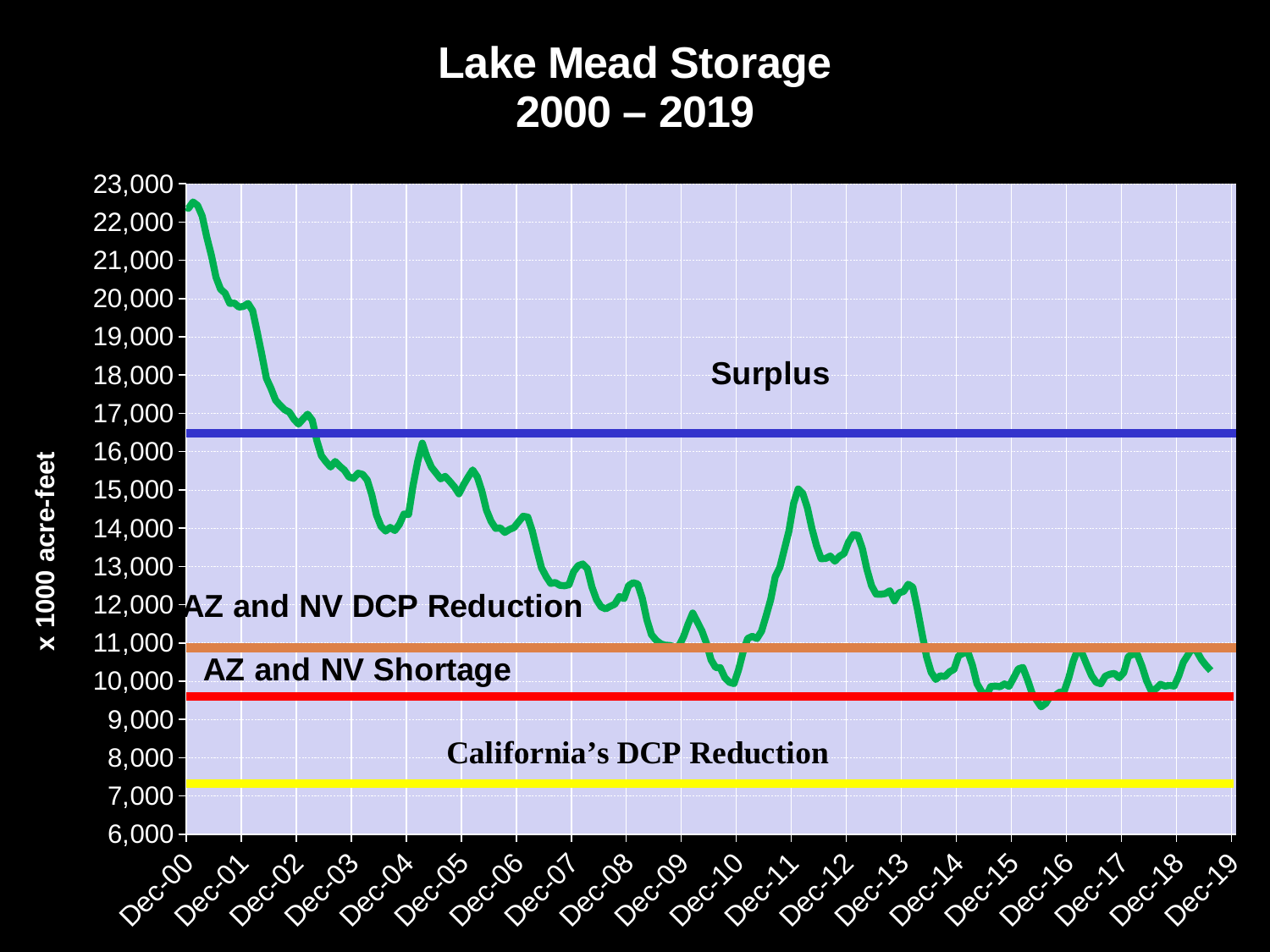
What kind of chart is shown on the slide? line chart What is the label on the y axis of the chart? x 1000 acre-feet Is the storage value at Dec-07 greater or less than 14,000? less Is the storage value at Dec-10 greater or less than 11,000? less Is the storage value at Dec-12 greater or less than 12,000? greater Overall, does the Lake Mead storage line rise or fall from Dec-00 to Dec-19? fall What is the title of the chart? Lake Mead Storage 2000 – 2019 How many date labels are shown on the x axis? 20 At which x-axis label is the storage line at its highest? Dec-00